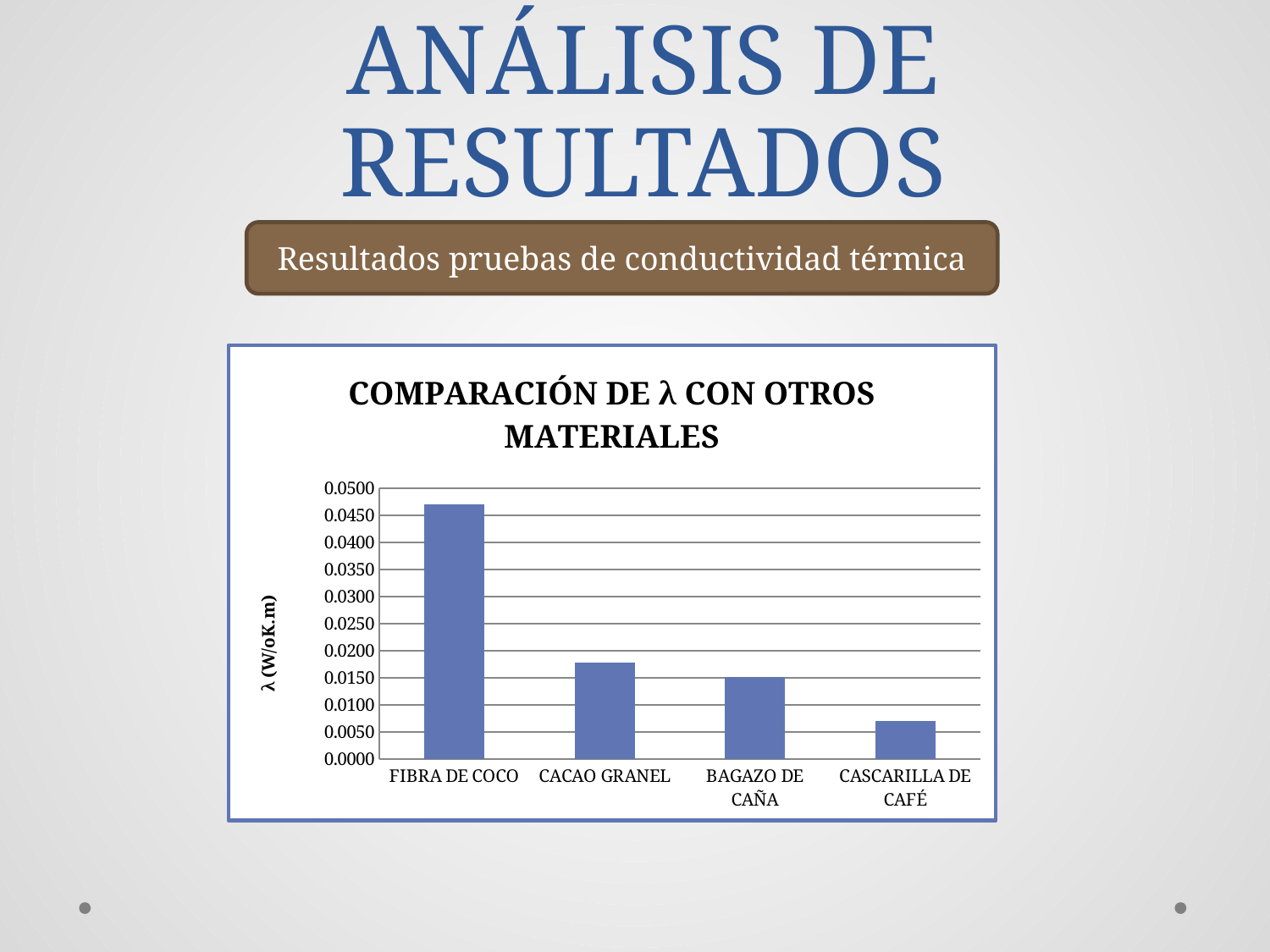
Which material has the lowest λ value? CASCARILLA DE CAFÉ Is the value for FIBRA DE COCO greater or less than 0.0450? greater What is the label on the vertical axis of the chart? λ (W/oK.m) Is the value for CASCARILLA DE CAFÉ greater or less than 0.0100? less Do the λ values rise or fall from left to right across the categories? fall Is the value for BAGAZO DE CAÑA greater or less than 0.0100? greater Which has a larger λ value, BAGAZO DE CAÑA or CASCARILLA DE CAFÉ? BAGAZO DE CAÑA What kind of chart is shown on the slide? bar chart Which material has the highest λ value? FIBRA DE COCO How many materials are compared in the chart? 4 Which has a larger λ value, FIBRA DE COCO or CACAO GRANEL? FIBRA DE COCO